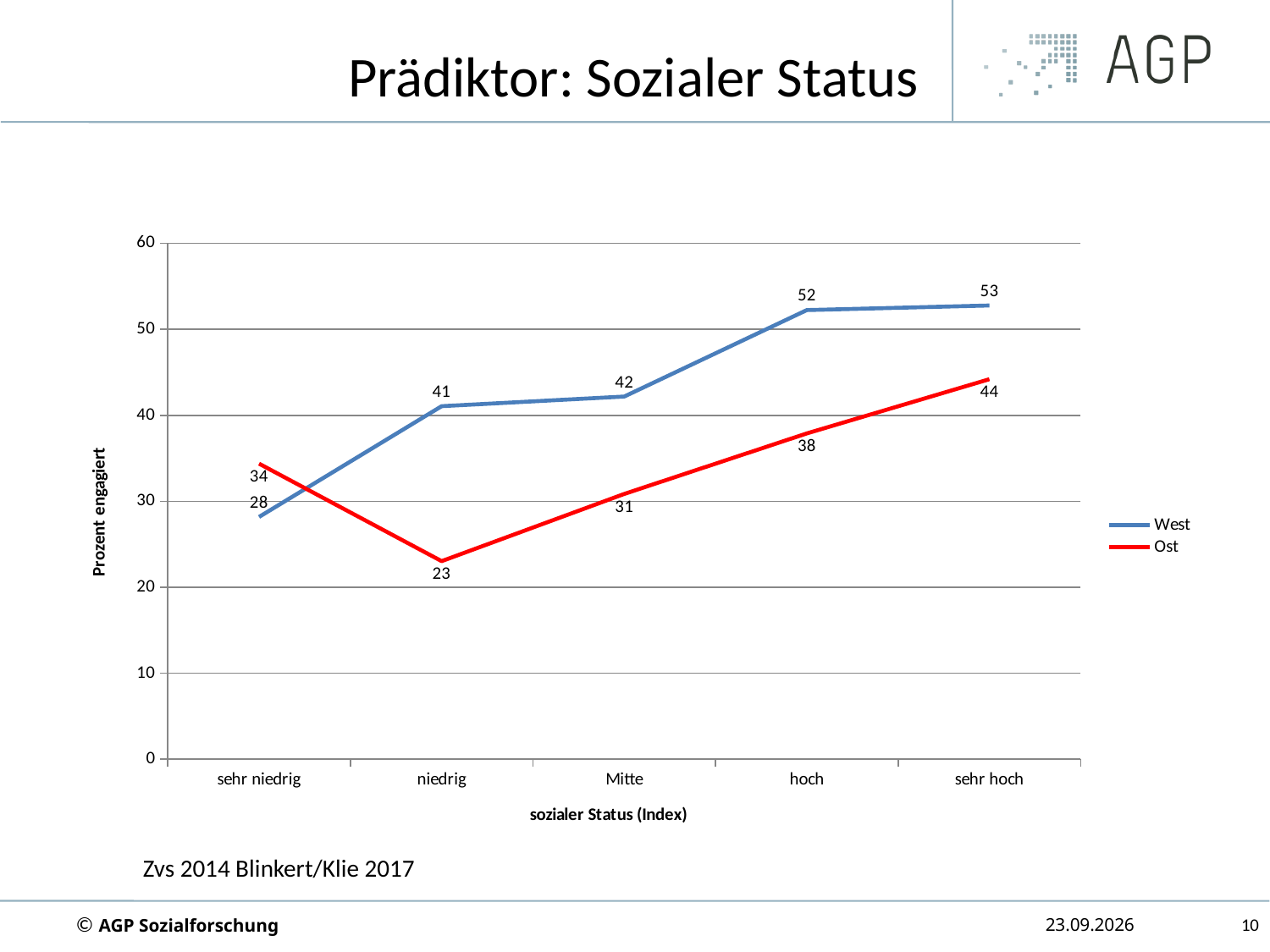
What is the value for West at "niedrig"? 41 What is the value for Ost at "Mitte"? 31 Is the value for West at "hoch" greater or less than 50? greater At "sehr niedrig", which series has the larger value, West or Ost? Ost What is the difference between West and Ost at "hoch"? 14 What is the value for Ost at "sehr hoch"? 44 Which social status category has the lowest value for Ost? niedrig Does the West series rise or fall from "sehr niedrig" to "sehr hoch"? rise Which social status category has the highest value for West? sehr hoch How many social status categories are shown on the x axis? 5 What kind of chart is shown on the slide? line chart How many series does the legend list? 2